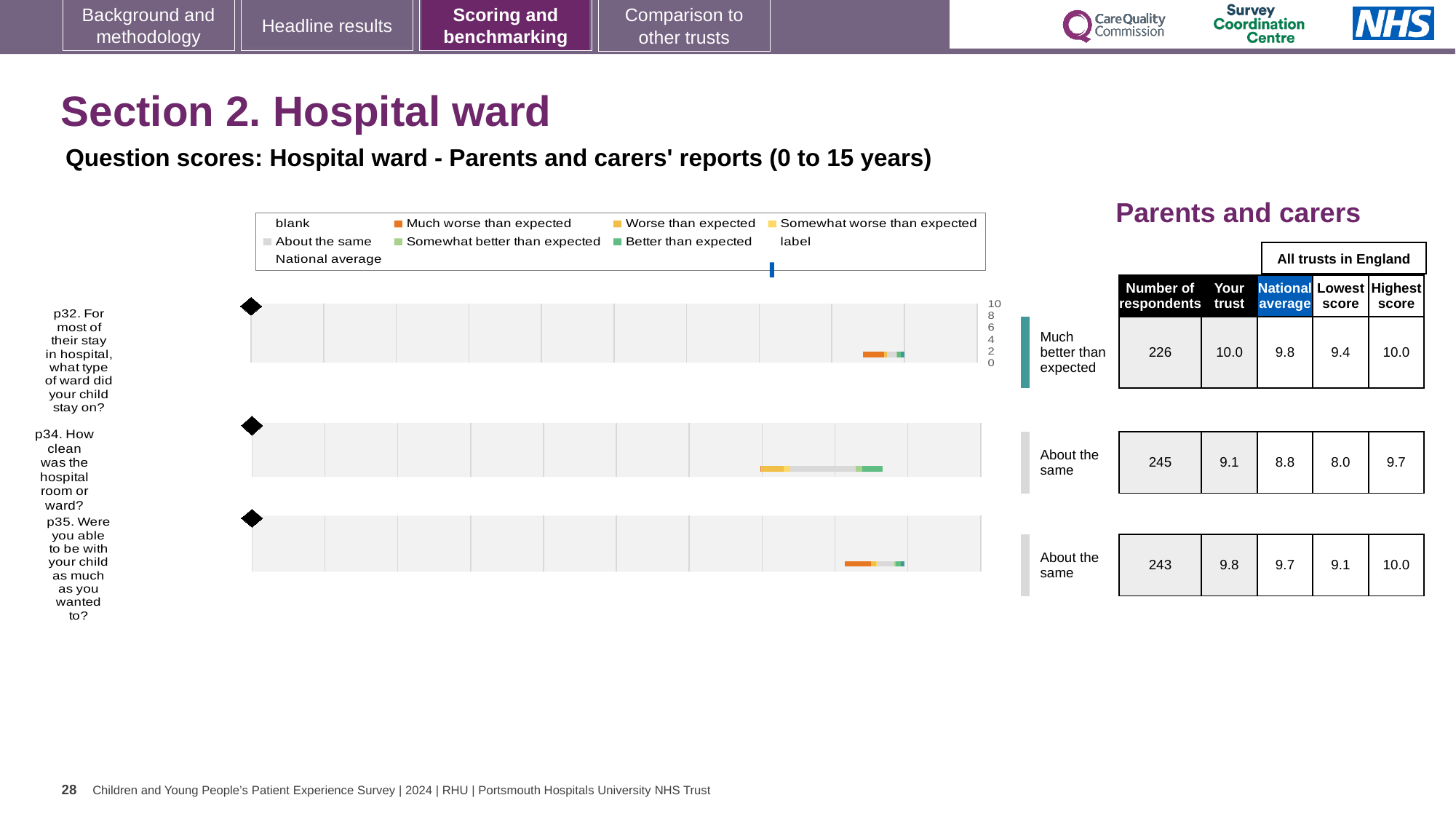
What is the national average score for p34 (how clean was the hospital room or ward)? 8.8 What is the 'Your trust' score for p32 (what type of ward did your child stay on)? 10.0 How many respondents answered p35 (were you able to be with your child as much as you wanted to)? 243 Which question has the highest 'Your trust' score? p32 Which question has the lowest 'Your trust' score? p34 What benchmark category is shown next to the bar for p32? Much better than expected What kind of chart is used to show the question scores on this slide? bar chart What is the difference between the 'Your trust' score and the national average for p34? 0.3 What is the highest score among all trusts in England for p34? 9.7 Which question had more respondents, p32 or p34? p34 Which colour does the legend use for 'Much worse than expected'? orange How many questions (categories) are plotted in the chart? 3